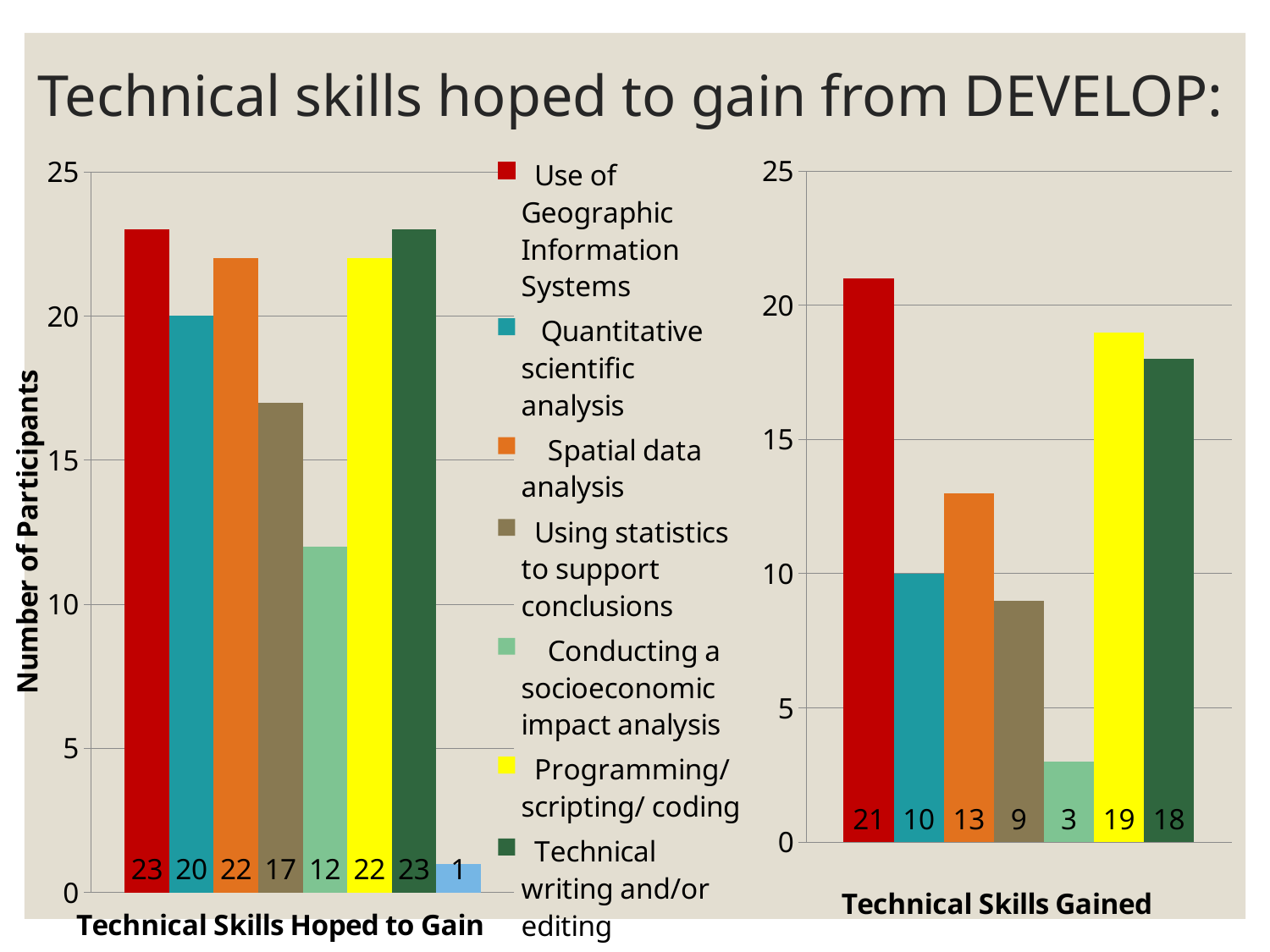
In the Technical Skills Gained chart, what is the value for Use of Geographic Information Systems? 21 What type of chart is used on this slide? Bar chart In the Technical Skills Gained chart, what is the difference between Programming/scripting/coding and Technical writing and/or editing? 1 In the Technical Skills Hoped to Gain chart, what is the value for Using statistics to support conclusions? 17 In the Technical Skills Hoped to Gain chart, how many participants hoped to gain Spatial data analysis skills? 22 In the Technical Skills Gained chart, which skill has the lowest number of participants? Conducting a socioeconomic impact analysis In the Technical Skills Gained chart, is the value for Programming/scripting/coding greater or less than 15? greater In the Technical Skills Hoped to Gain chart, what is the difference between Use of Geographic Information Systems and Conducting a socioeconomic impact analysis? 11 In the Technical Skills Gained chart, which skill has the highest number of participants? Use of Geographic Information Systems In the Technical Skills Gained chart, which is larger: Quantitative scientific analysis or Spatial data analysis? Spatial data analysis In the Technical Skills Gained chart, what is the value for Technical writing and/or editing? 18 How many bars are shown in the Technical Skills Gained chart? 7